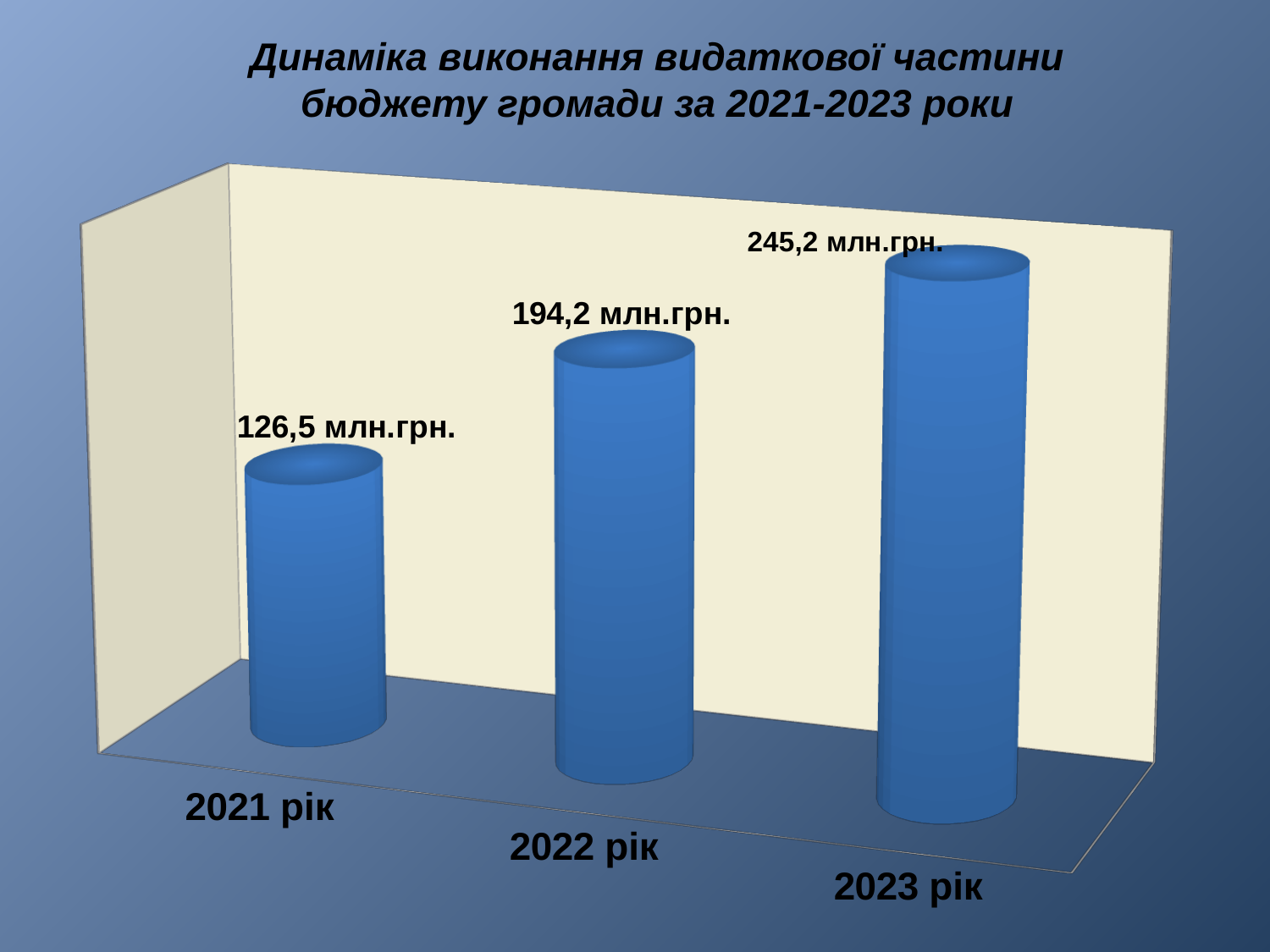
Which year has the highest value? 2023 рік What is the difference between the values for 2022 рік and 2021 рік? 67,7 млн.грн. Which is larger, the value for 2021 рік or the value for 2022 рік? 2022 рік What is the value shown for 2021 рік? 126,5 млн.грн. What is the title of the chart? Динаміка виконання видаткової частини бюджету громади за 2021-2023 роки What kind of chart is shown on the slide? Bar chart What is the difference between the values for 2023 рік and 2022 рік? 51,0 млн.грн. Which year has the lowest value? 2021 рік What is the value shown for 2022 рік? 194,2 млн.грн. How many years (categories) are shown in the chart? 3 Do the values rise or fall from 2021 рік to 2023 рік? Rise What is the value shown for 2023 рік? 245,2 млн.грн.